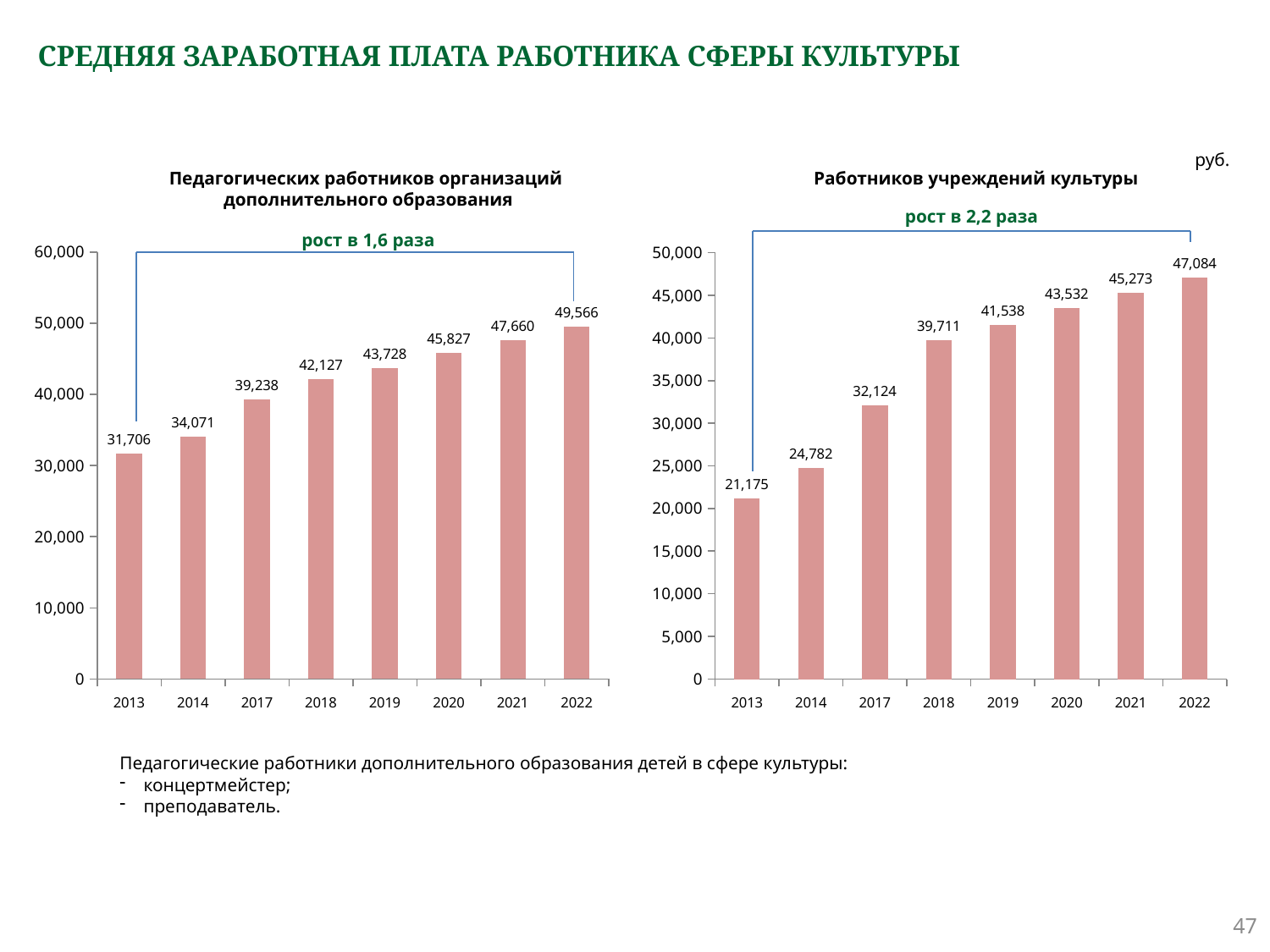
In the left chart (Педагогических работников организаций дополнительного образования), what is the value for 2013? 31,706 In the left chart (Педагогических работников организаций дополнительного образования), what is the difference between the values for 2022 and 2013? 17,860 In the right chart (Работников учреждений культуры), which year has the lowest value? 2013 How many years are shown on the x axis of the right chart (Работников учреждений культуры)? 8 Which is larger: the 2020 value in the left chart or the 2020 value in the right chart? The left chart (45,827) What type of chart is the left chart (Педагогических работников организаций дополнительного образования)? Bar chart In the right chart (Работников учреждений культуры), what is the value for 2022? 47,084 In the left chart (Педагогических работников организаций дополнительного образования), which year has the highest value? 2022 In the left chart (Педагогических работников организаций дополнительного образования), what is the value for 2019? 43,728 In the right chart (Работников учреждений культуры), what is the difference between the values for 2014 and 2013? 3,607 In the right chart (Работников учреждений культуры), what is the value for 2018? 39,711 In the right chart (Работников учреждений культуры), do the values rise or fall from 2013 to 2022? Rise